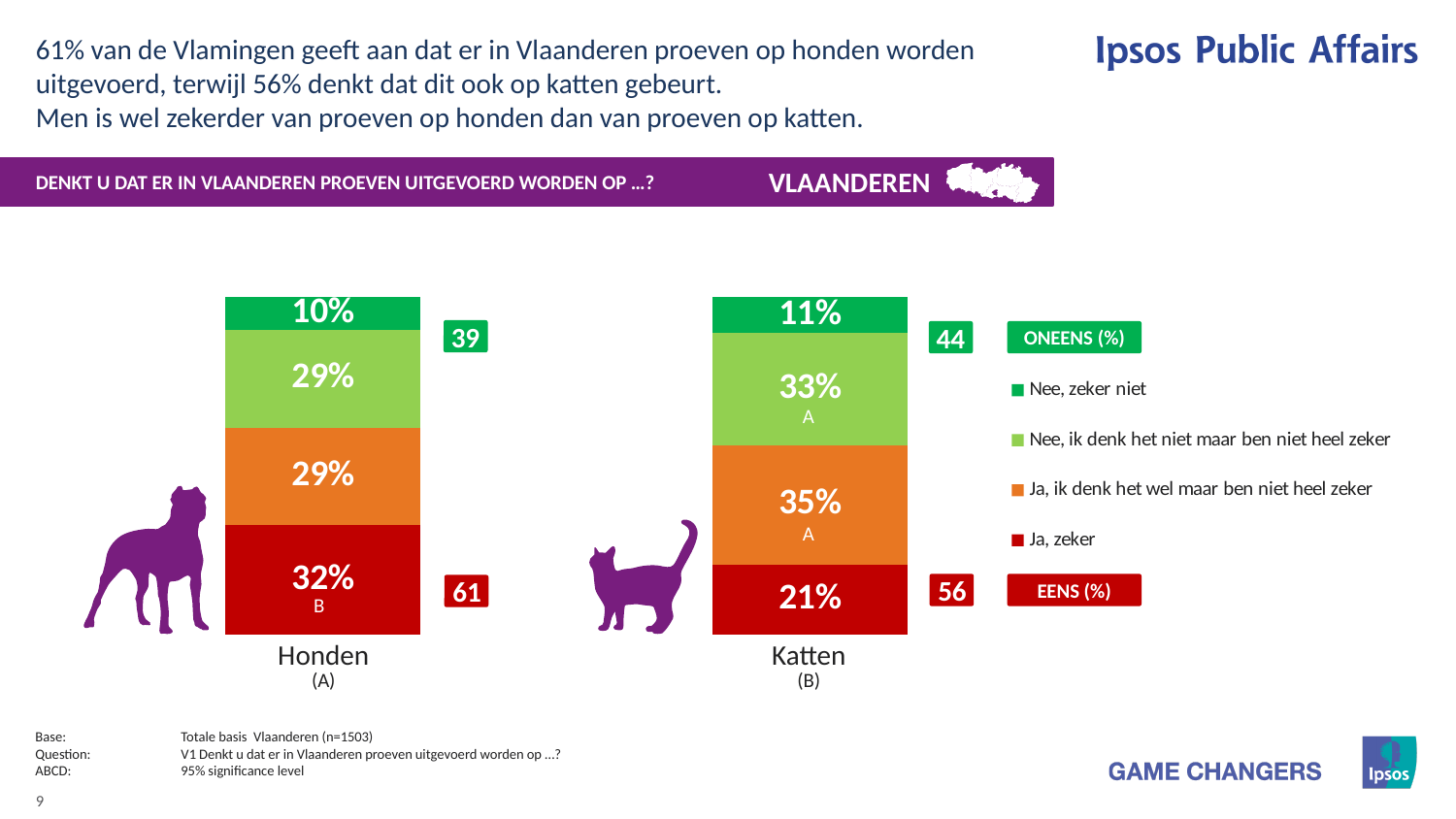
Which category has the larger "Ja, zeker" share, Honden or Katten? Honden What is the difference between the "Ja, zeker" values for Honden and Katten? 11 percentage points What percentage of respondents answered "Ja, zeker" for Katten? 21% What percentage of respondents answered "Ja, zeker" for Honden? 32% How many categories are shown on the x axis of the chart? 2 What is the EENS (%) total shown for Honden? 61 What is the combined share of the two "Ja" segments for Katten? 56% What is the value of the "Ja, ik denk het wel maar ben niet heel zeker" segment for Honden? 29% What kind of chart is shown on the slide? Stacked bar chart How many series does the legend list? 4 What is the value of the "Nee, zeker niet" segment for Katten? 11% What is the ONEENS (%) total shown for Katten? 44